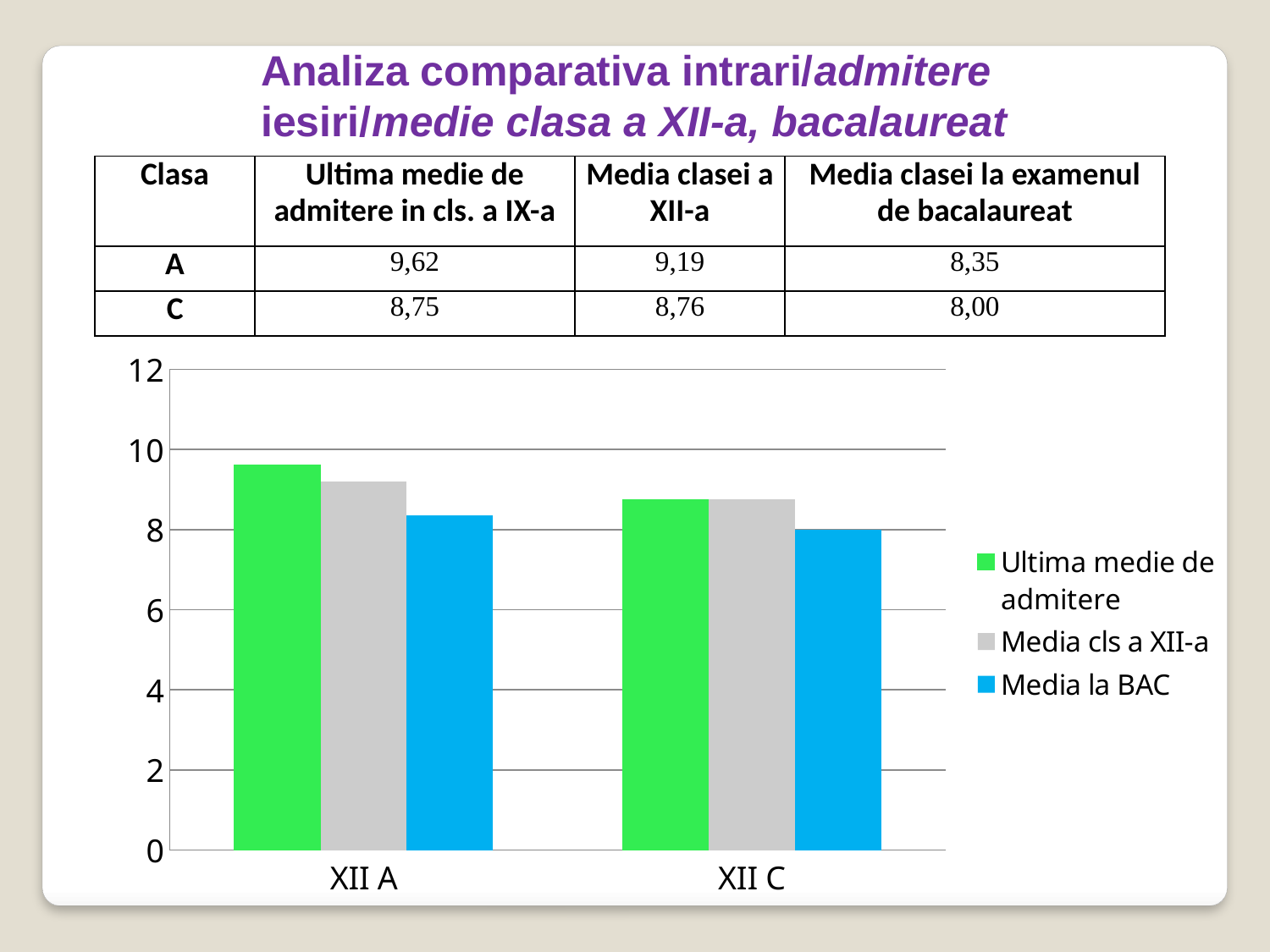
What is the value of Media la BAC for XII C? 8,00 How many categories are shown on the x axis of the chart? 2 What is the difference between Ultima medie de admitere and Media la BAC for XII A? 1,27 What is the value of Ultima medie de admitere for XII A? 9,62 How many series does the chart legend list? 3 Which series has the highest value for XII A? Ultima medie de admitere What kind of chart is shown on the slide? bar chart Which is larger: Ultima medie de admitere for XII A or Ultima medie de admitere for XII C? XII A What is the value of Media cls a XII-a for XII A? 9,19 Is the value of Media la BAC for XII A greater or less than 8? greater Which series has the lowest value for XII C? Media la BAC What colour are the Media la BAC bars in the chart? blue